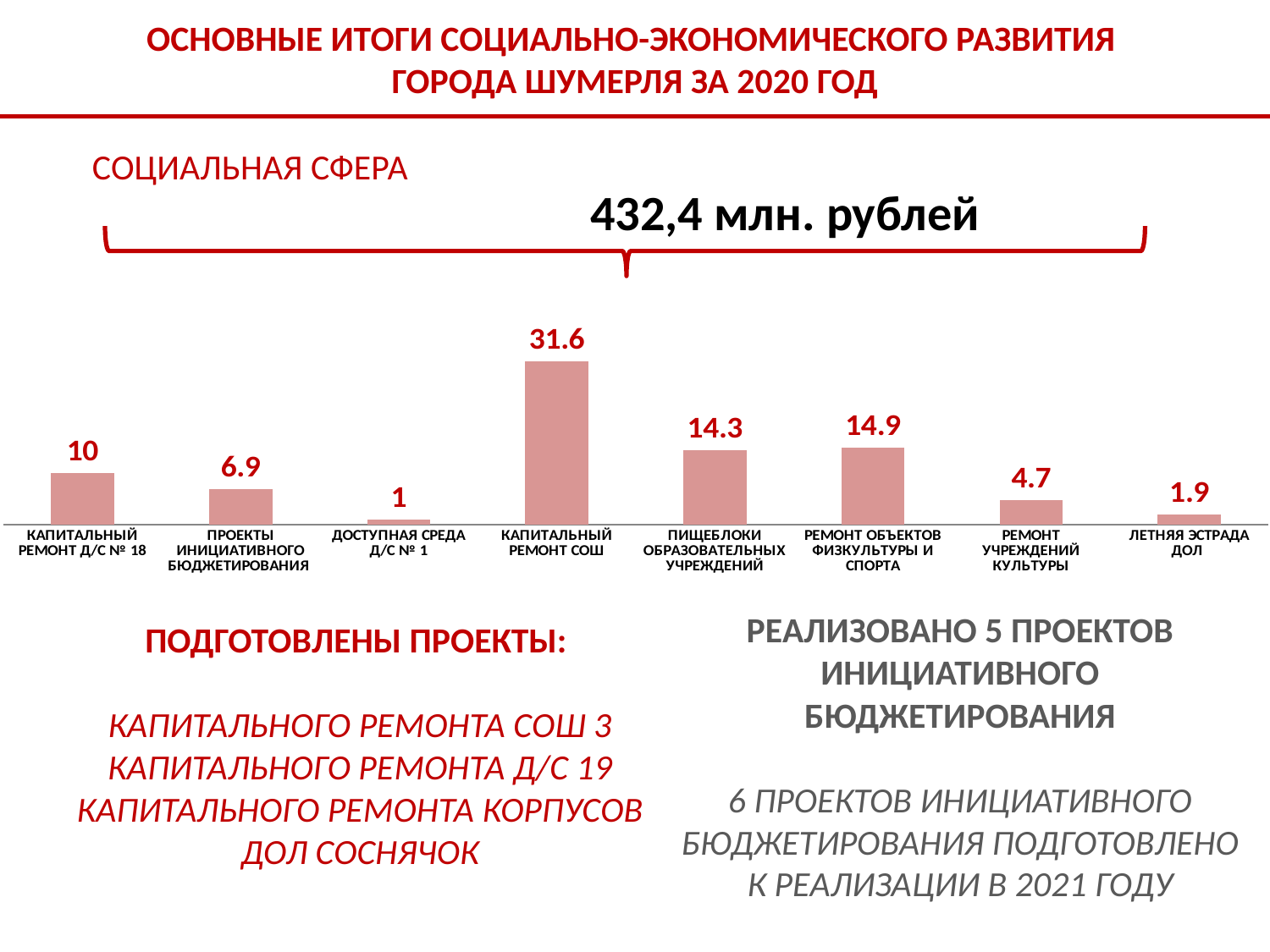
Which category has the lowest value? ДОСТУПНАЯ СРЕДА Д/С № 1 What is the value for ПРОЕКТЫ ИНИЦИАТИВНОГО БЮДЖЕТИРОВАНИЯ? 6.9 Which category has the highest value? КАПИТАЛЬНЫЙ РЕМОНТ СОШ What kind of chart is shown on the slide? bar chart What is the difference between the values for КАПИТАЛЬНЫЙ РЕМОНТ СОШ and КАПИТАЛЬНЫЙ РЕМОНТ Д/С № 18? 21.6 Which is larger: the value for КАПИТАЛЬНЫЙ РЕМОНТ Д/С № 18 or the value for РЕМОНТ УЧРЕЖДЕНИЙ КУЛЬТУРЫ? КАПИТАЛЬНЫЙ РЕМОНТ Д/С № 18 What is the value for КАПИТАЛЬНЫЙ РЕМОНТ СОШ? 31.6 What total amount is shown above the chart for the social sphere? 432,4 млн. рублей What is the value for ПИЩЕБЛОКИ ОБРАЗОВАТЕЛЬНЫХ УЧРЕЖДЕНИЙ? 14.3 How many categories are shown in the chart? 8 What is the value for ЛЕТНЯЯ ЭСТРАДА ДОЛ? 1.9 What is the difference between the values for РЕМОНТ ОБЪЕКТОВ ФИЗКУЛЬТУРЫ И СПОРТА and ПИЩЕБЛОКИ ОБРАЗОВАТЕЛЬНЫХ УЧРЕЖДЕНИЙ? 0.6